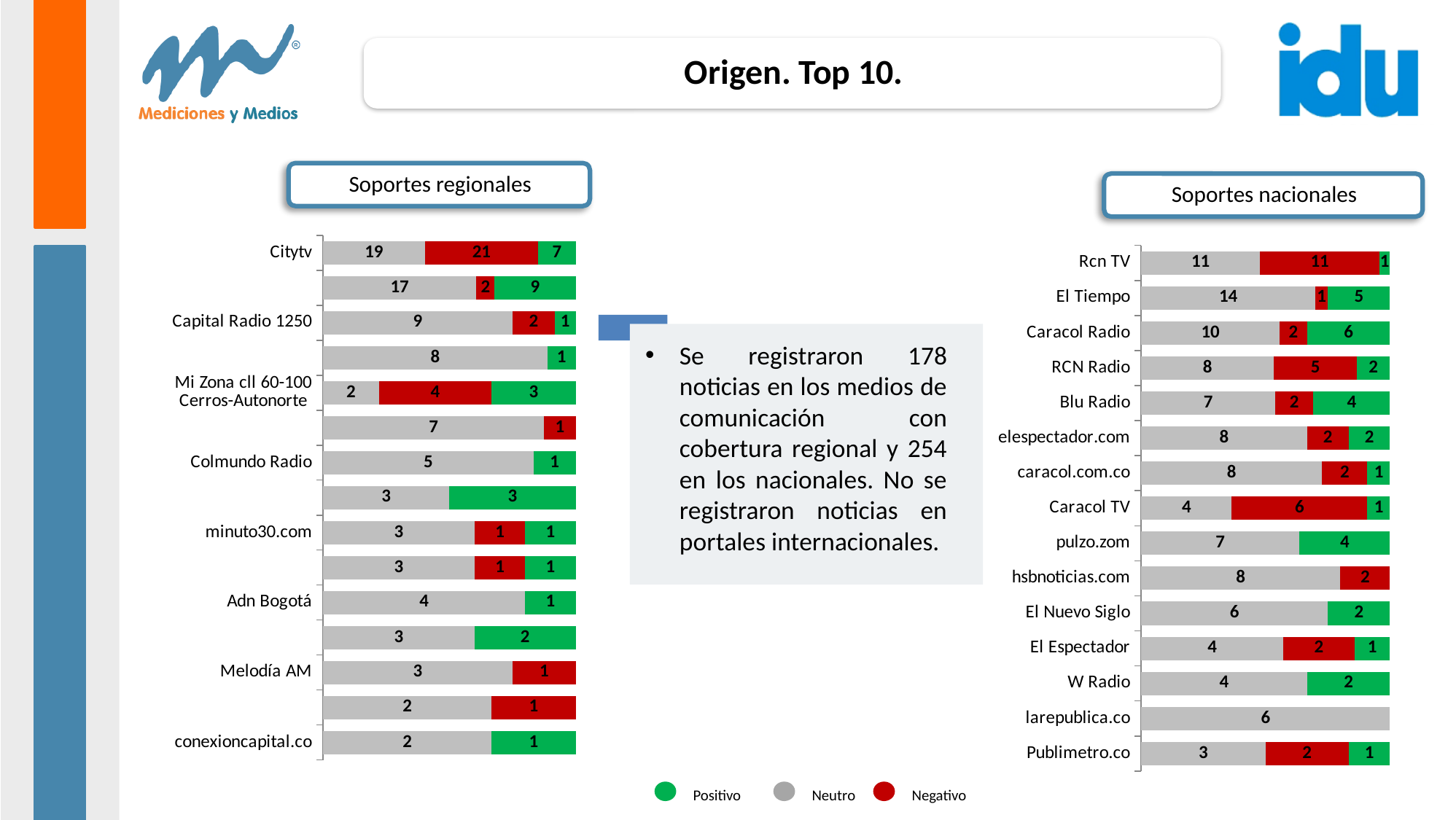
In the Soportes regionales chart, what is the total of the stacked bar for Citytv? 47 In the Soportes nacionales chart, what is the Negativo value for Caracol TV? 6 What kind of chart is the Soportes nacionales chart? Stacked bar chart In the Soportes nacionales chart, what is the difference between the Neutro values for El Tiempo and Blu Radio? 7 In the Soportes regionales chart, what is the Neutro value for Capital Radio 1250? 9 In the Soportes regionales chart, what is the total of the stacked bar for Mi Zona cll 60-100 Cerros-Autonorte? 9 In the Soportes nacionales chart, which has the larger Positivo value, El Tiempo or RCN Radio? El Tiempo How many series does the legend list? 3 In the Soportes nacionales chart, which category has the highest total stacked bar? Rcn TV In the Soportes regionales chart, what is the Negativo value for Citytv? 21 In the Soportes nacionales chart, what is the Positivo value for Caracol Radio? 6 In the Soportes nacionales chart, what is the total of the stacked bar for Rcn TV? 23